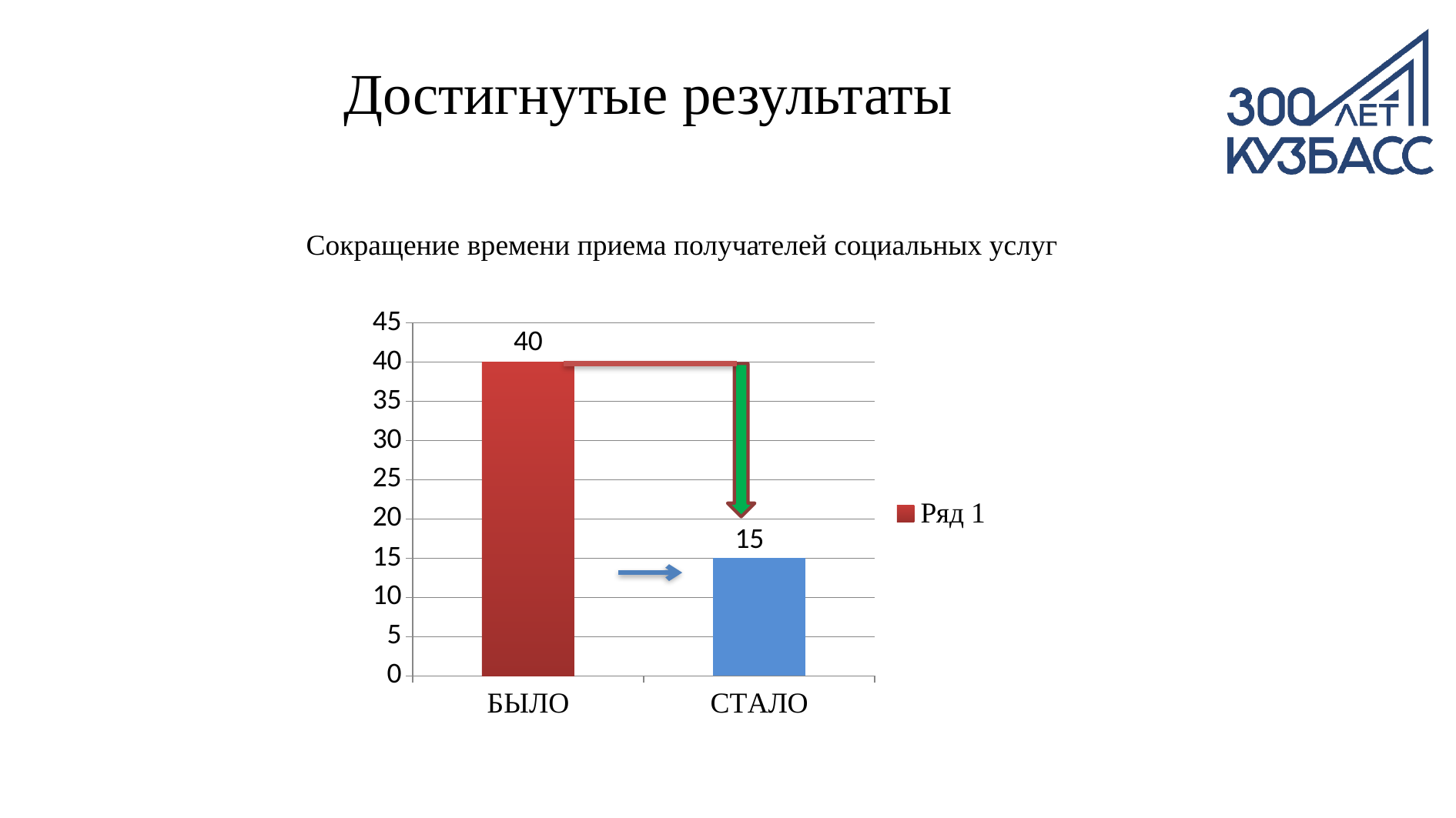
What is the name of the series listed in the legend? Ряд 1 What kind of chart is shown on the slide? bar chart What is the difference between the values for БЫЛО and СТАЛО? 25 Which category has the lowest value? СТАЛО How many categories are shown on the x axis? 2 Which category has the highest value? БЫЛО How many series does the legend list? 1 Which is larger, the value for БЫЛО or the value for СТАЛО? БЫЛО Is the value for СТАЛО greater or less than 20? less Is the value for БЫЛО greater or less than 35? greater What is the value for СТАЛО? 15 What is the value for БЫЛО? 40